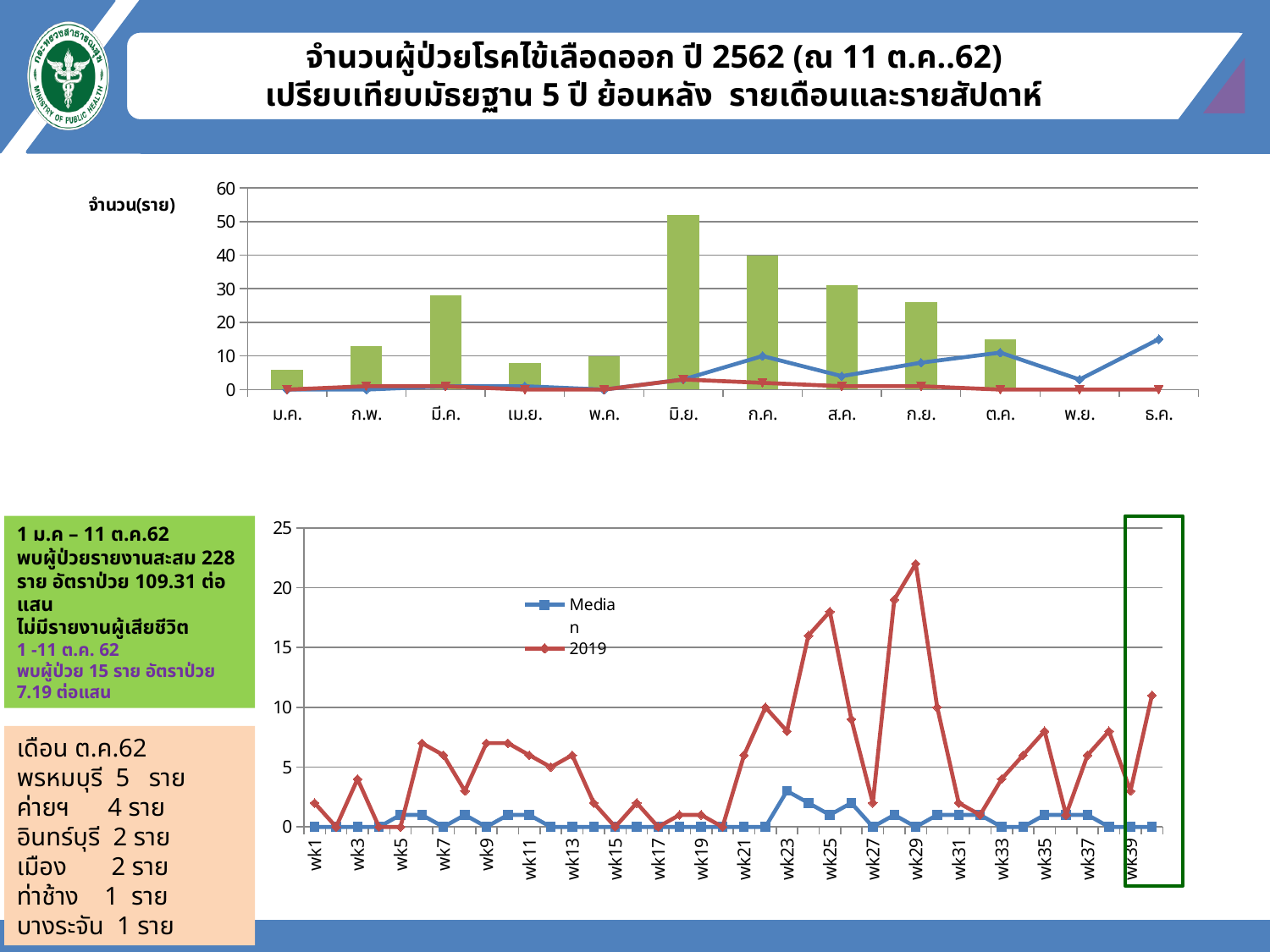
In the top chart, is the bar for มิ.ย. greater or less than 40? greater In the top chart, which month has the tallest bar? มิ.ย. In the top chart, how many months are shown on the x axis? 12 What kind of chart is the bottom chart? line chart In the bottom chart, is the 2019 value at wk29 greater or less than 20? greater How many series does the legend of the bottom chart list? 2 In the bottom chart, at which week does the 2019 line reach its highest point? wk29 In the top chart, which bar is taller, ส.ค. or ก.ย.? ส.ค. In the top chart, is the bar for ม.ค. greater or less than 10? less In the top chart, which bar is taller, มิ.ย. or ก.ค.? มิ.ย. What are the two series named in the legend of the bottom chart? Median and 2019